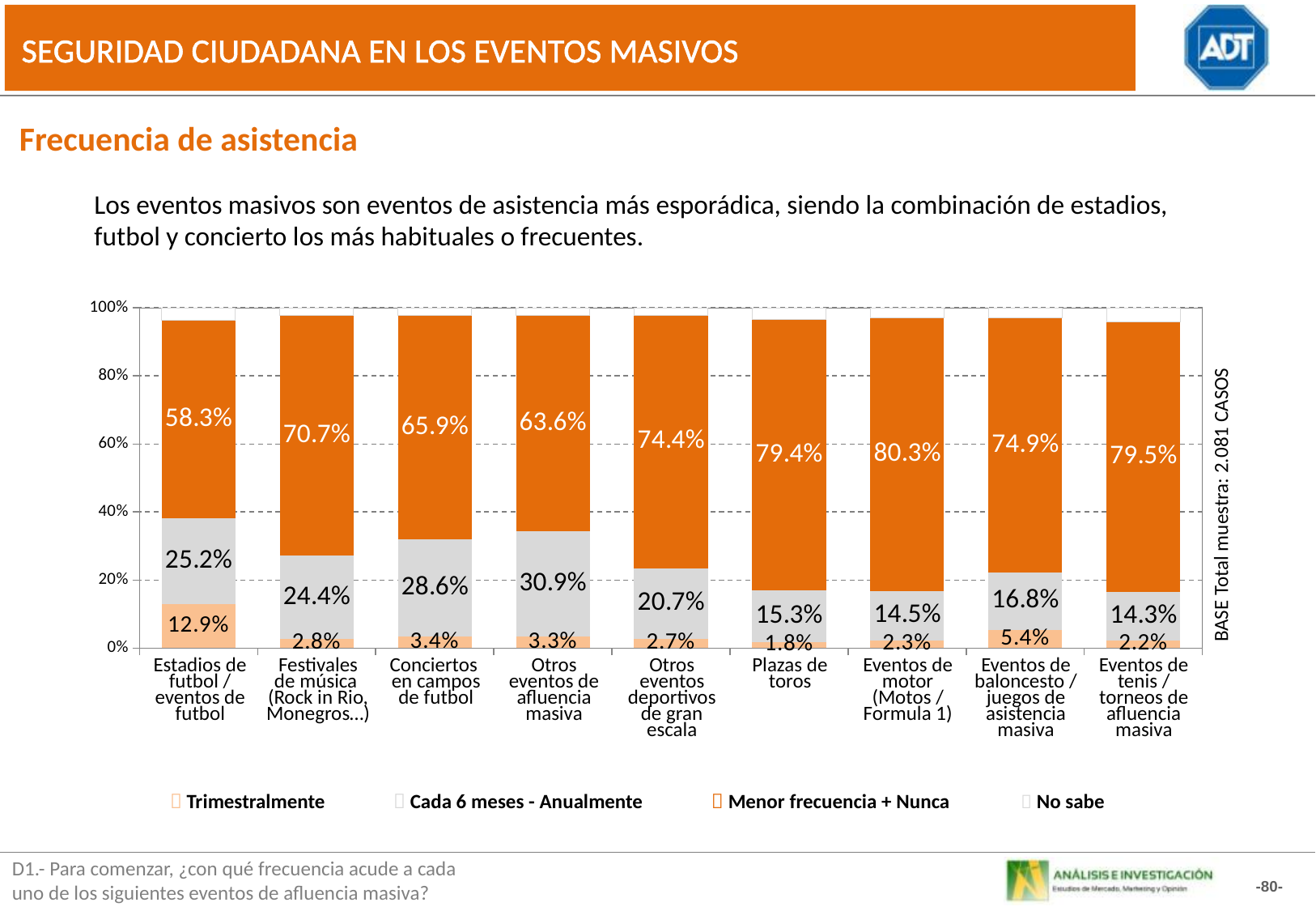
How many series does the chart legend list? 4 How many event categories are shown on the x axis of the chart? 9 What is the 'Cada 6 meses - Anualmente' value for 'Plazas de toros'? 15.3% Which category has the highest 'Menor frecuencia + Nunca' value? Eventos de motor (Motos / Formula 1) Which category has the lowest 'Trimestralmente' value? Plazas de toros Which category has the highest 'Cada 6 meses - Anualmente' value? Otros eventos de afluencia masiva What kind of chart is shown on the slide? Stacked bar chart Which category has the lowest 'Menor frecuencia + Nunca' value? Estadios de futbol / eventos de futbol Which is larger: the 'Cada 6 meses - Anualmente' value for 'Conciertos en campos de futbol' or for 'Festivales de música (Rock in Rio, Monegros…)'? Conciertos en campos de futbol What is the 'Trimestralmente' value for 'Eventos de baloncesto / juegos de asistencia masiva'? 5.4% What is the difference between the 'Trimestralmente' values for 'Estadios de futbol / eventos de futbol' and 'Eventos de baloncesto / juegos de asistencia masiva'? 7.5 percentage points What is the 'Menor frecuencia + Nunca' value for 'Estadios de futbol / eventos de futbol'? 58.3%